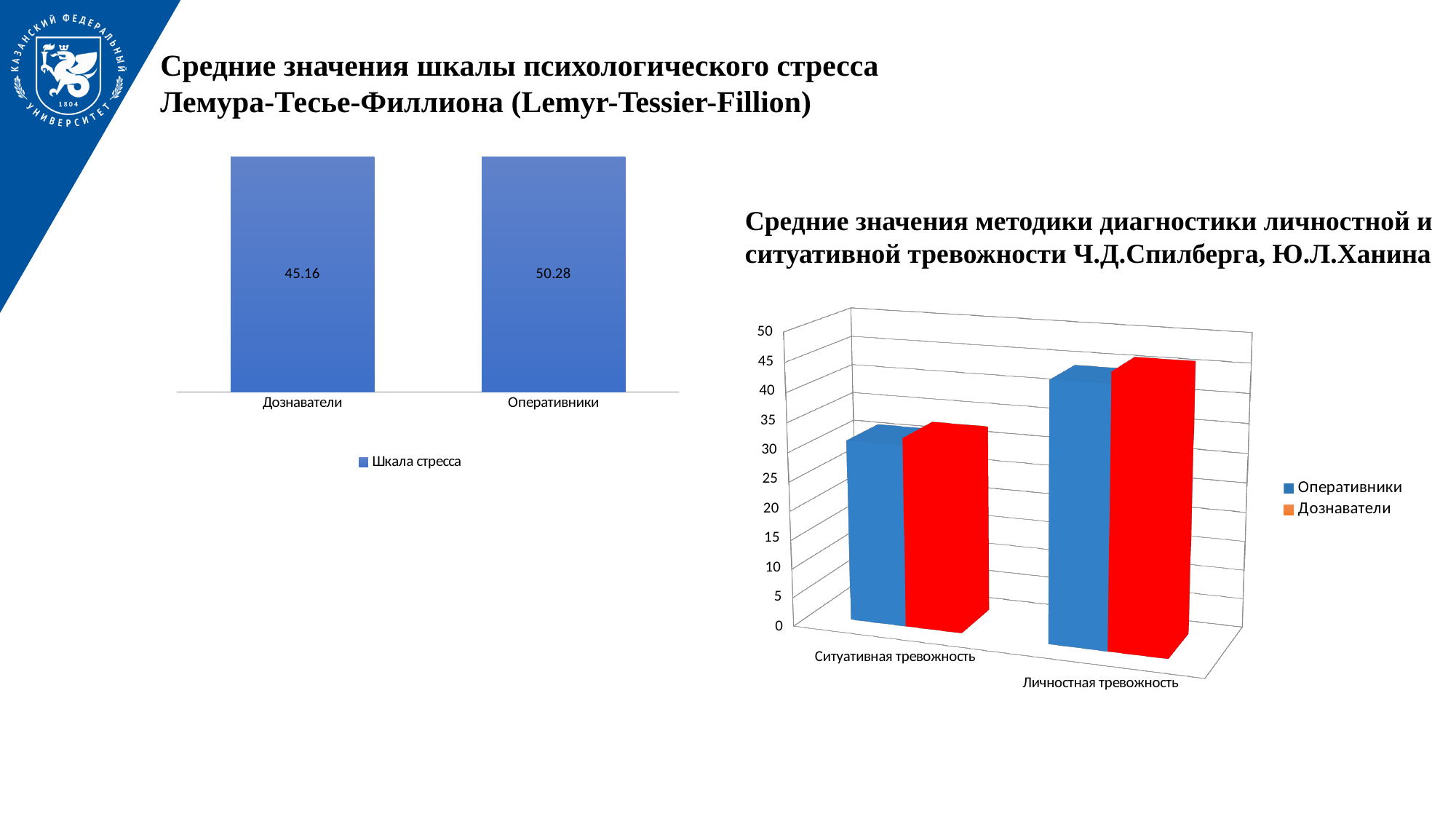
On the left chart (Средние значения шкалы психологического стресса), what series name does the legend show? Шкала стресса On the left chart (Средние значения шкалы психологического стресса), which category has the higher value? Оперативники On the right chart (Средние значения методики диагностики личностной и ситуативной тревожности), is the value for Оперативники in Личностная тревожность greater or less than 40? greater On the right chart (Средние значения методики диагностики личностной и ситуативной тревожности), how many series does the legend list? 2 On the left chart (Средние значения шкалы психологического стресса), what is the difference between the values for Оперативники and Дознаватели? 5.12 On the right chart (Средние значения методики диагностики личностной и ситуативной тревожности), is the value for Оперативники in Ситуативная тревожность greater or less than 35? less On the right chart (Средние значения методики диагностики личностной и ситуативной тревожности), for Оперативники, which category has the larger value: Ситуативная тревожность or Личностная тревожность? Личностная тревожность On the right chart (Средние значения методики диагностики личностной и ситуативной тревожности), what kind of chart is it? Bar chart On the left chart (Средние значения шкалы психологического стресса), how many categories are plotted? 2 On the left chart (Средние значения шкалы психологического стресса), what is the value for Дознаватели? 45.16 On the left chart (Средние значения шкалы психологического стресса), what is the value for Оперативники? 50.28